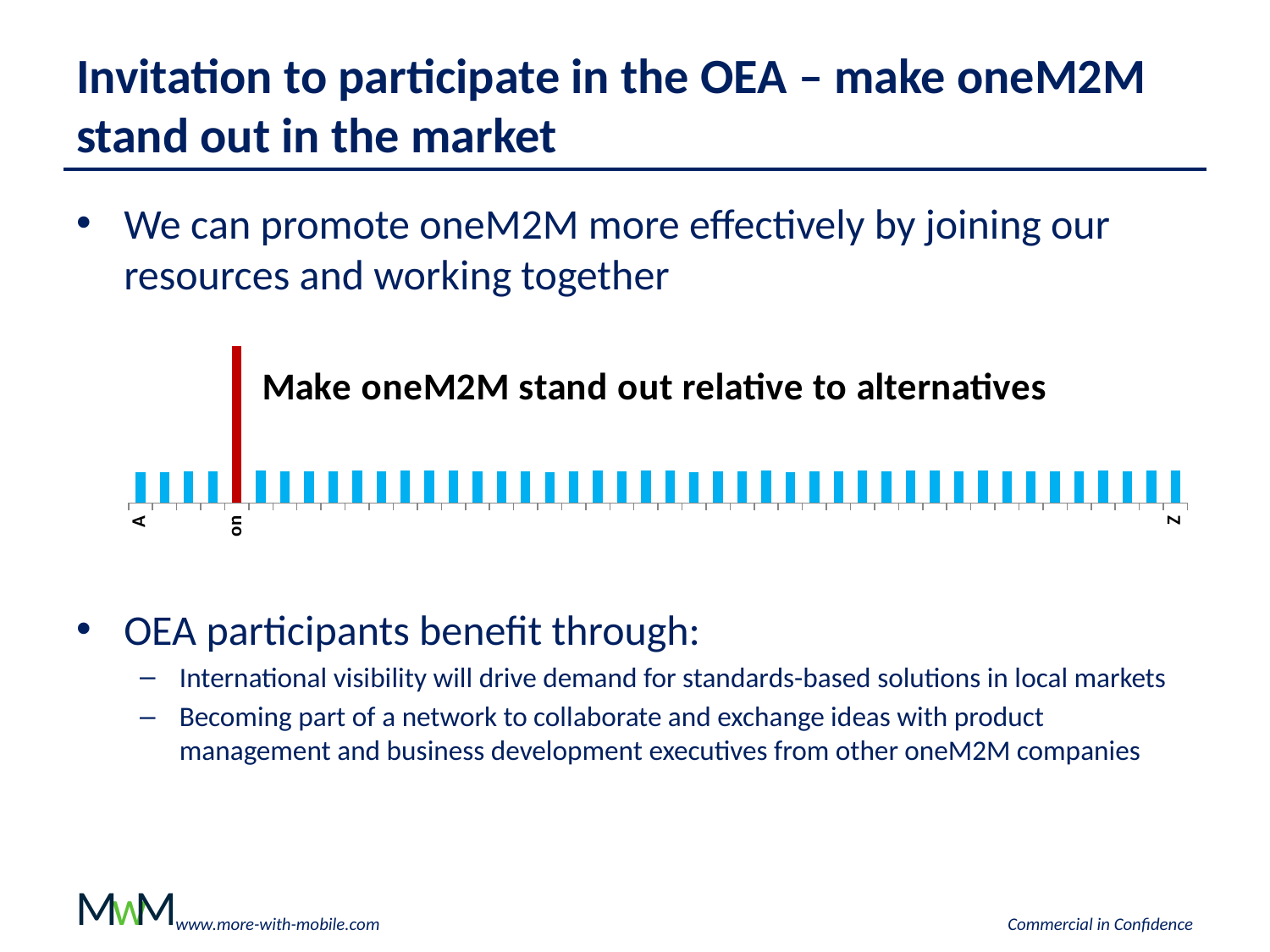
What colour is the tallest bar in the chart? red Which is larger in the chart, the bar for "on" or the bar for "A"? on What kind of chart is shown on the slide? bar chart Which is larger in the chart, the bar for "Z" or the bar for "on"? on What text is written above the bars in the chart? Make oneM2M stand out relative to alternatives Which category has the highest bar in the chart? on